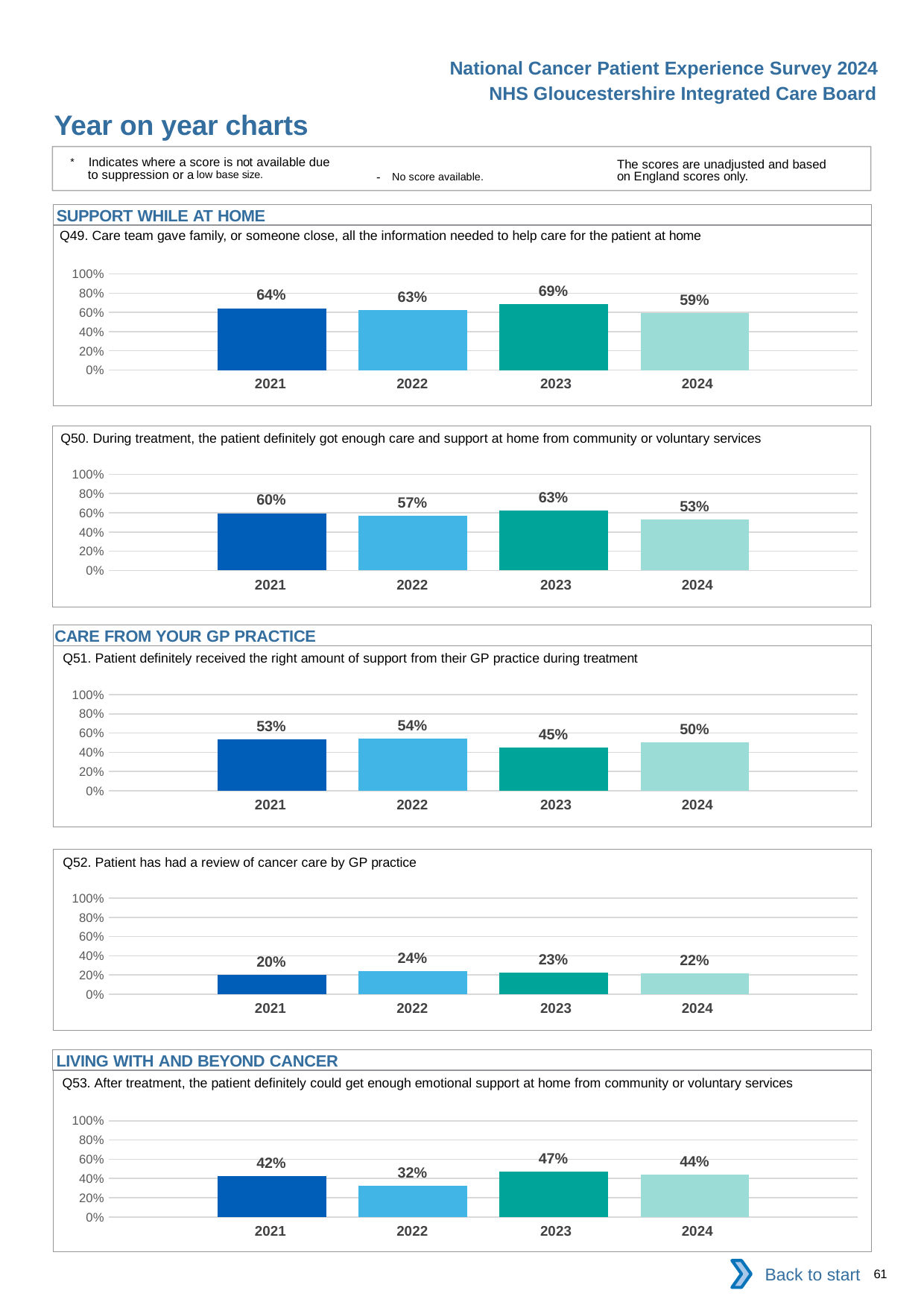
In the Q52 chart, is the value for 2021 greater or less than 40%? less Which section heading appears above the Q53 chart? LIVING WITH AND BEYOND CANCER In the Q52 chart, which year has the highest value? 2022 In the Q51 chart, what is the value for 2024? 50% In the Q50 chart, what is the difference between the 2021 and 2024 values? 7% In the Q49 chart, how many years are shown? 4 What type of chart is the Q50 chart? bar chart In the Q51 chart, what is the difference between the 2022 and 2023 values? 9% In the Q50 chart, which year has the lowest value? 2024 In the Q49 chart, what is the value for 2023? 69% In the Q53 chart, what is the value for 2022? 32% In the Q53 chart, is the value for 2021 larger or smaller than the value for 2024? smaller